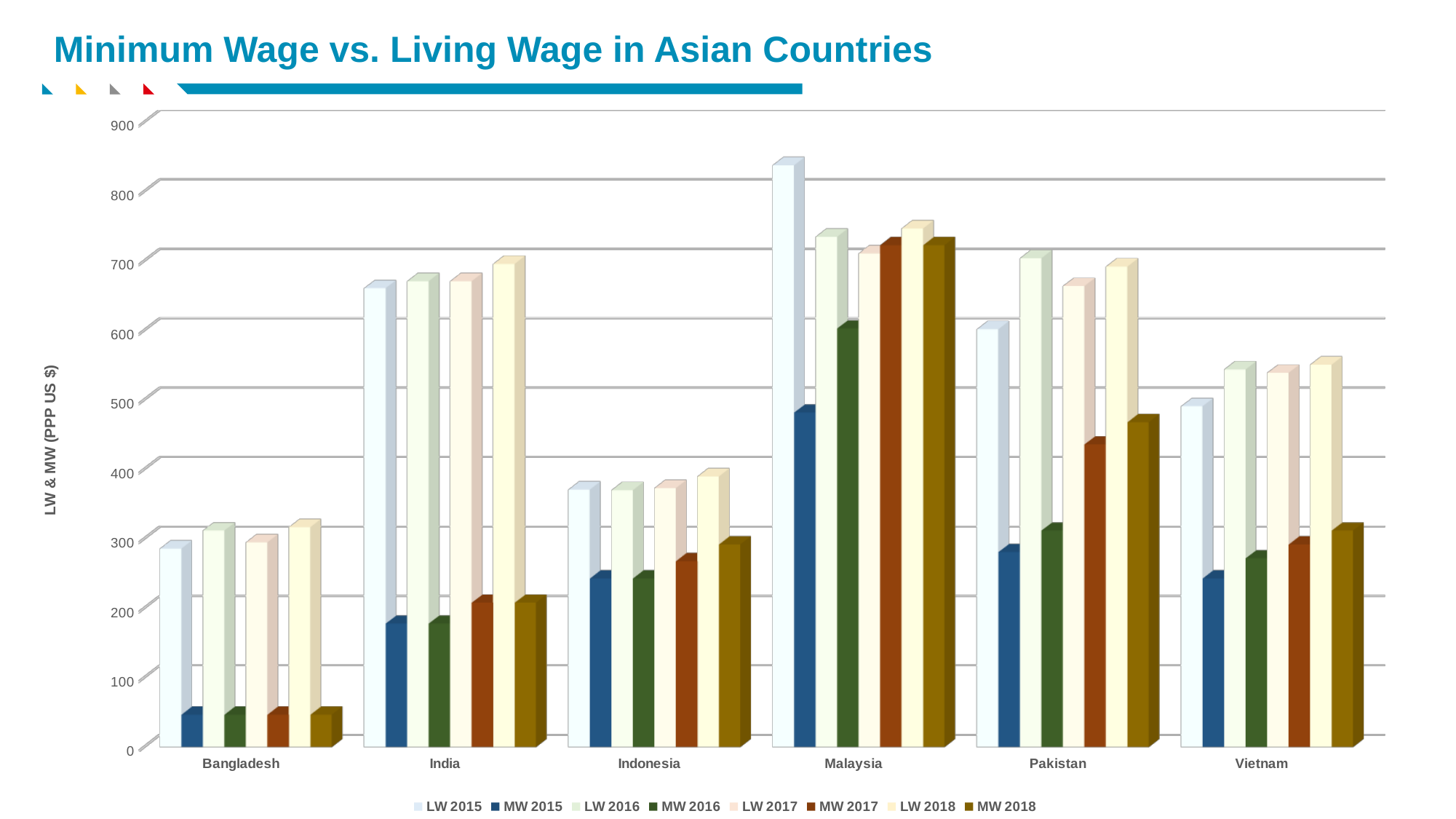
How many countries are shown on the x axis? 6 How many series does the legend list? 8 Is the LW 2015 value for Malaysia greater or less than 800? greater Is the MW 2018 value for Pakistan greater or less than 400? greater Which is larger, the MW 2016 value for Malaysia or the MW 2016 value for Pakistan? Malaysia What type of chart is shown on the slide? Bar chart What is the label on the y axis? LW & MW (PPP US $) Is the MW 2015 value for Bangladesh greater or less than 100? less Do the MW values for Pakistan rise or fall from 2015 to 2018? rise Which country has the highest LW 2015 value? Malaysia Which country has the lowest MW 2015 value? Bangladesh